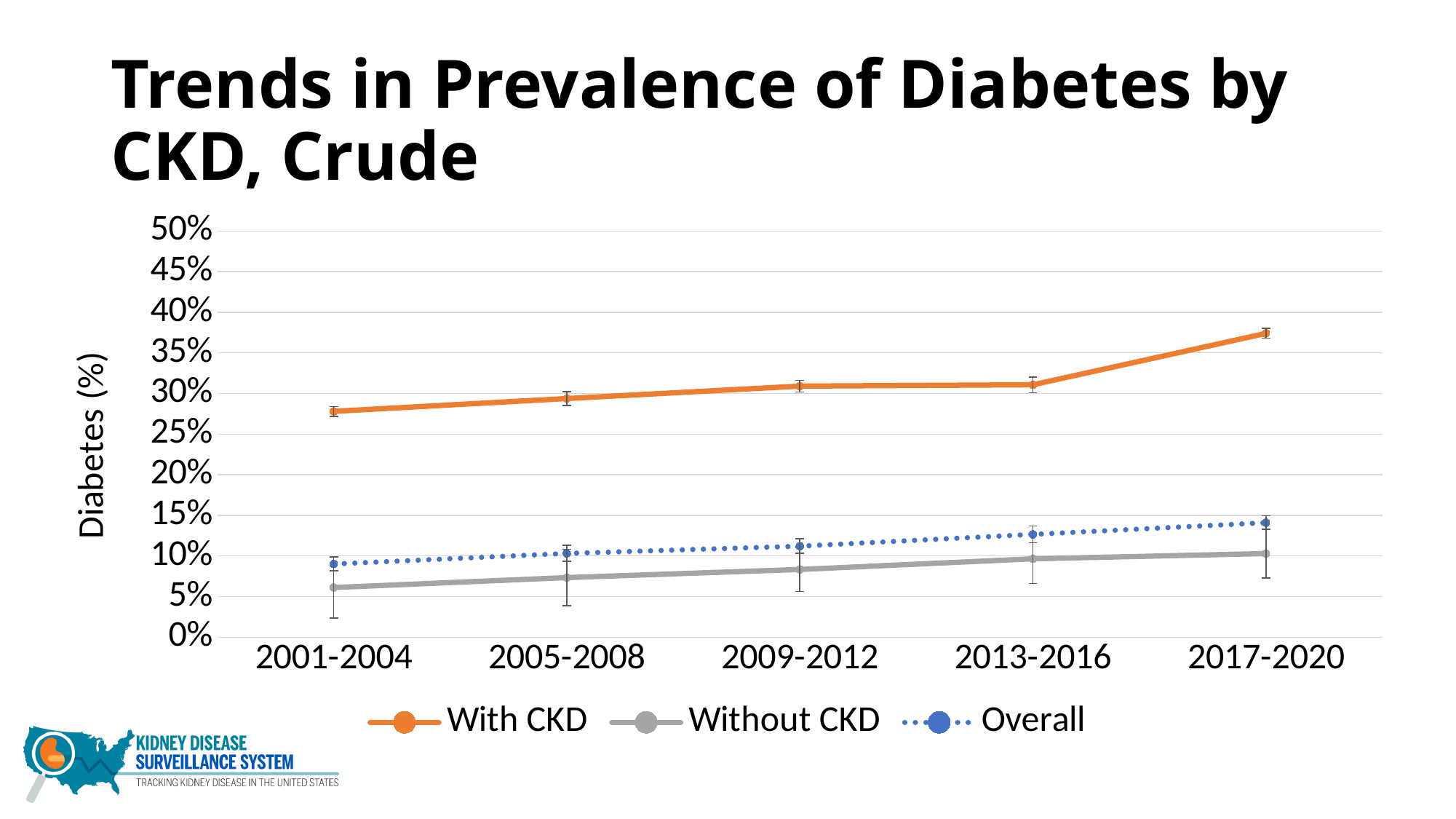
Is the With CKD value for 2001-2004 greater or less than 30%? less How many time periods are shown on the x axis? 5 Does the Without CKD series rise or fall from 2001-2004 to 2017-2020? rise In which period is the With CKD value lowest? 2001-2004 Which series has the lowest diabetes prevalence across all periods? Without CKD Is the With CKD value for 2017-2020 greater or less than 35%? greater What is the label on the y axis? Diabetes (%) Is the Without CKD value for 2001-2004 greater or less than 10%? less What kind of chart is shown on the slide? Line chart Which series has the highest diabetes prevalence across all periods? With CKD How many series does the legend list? 3 In which period is the With CKD value highest? 2017-2020